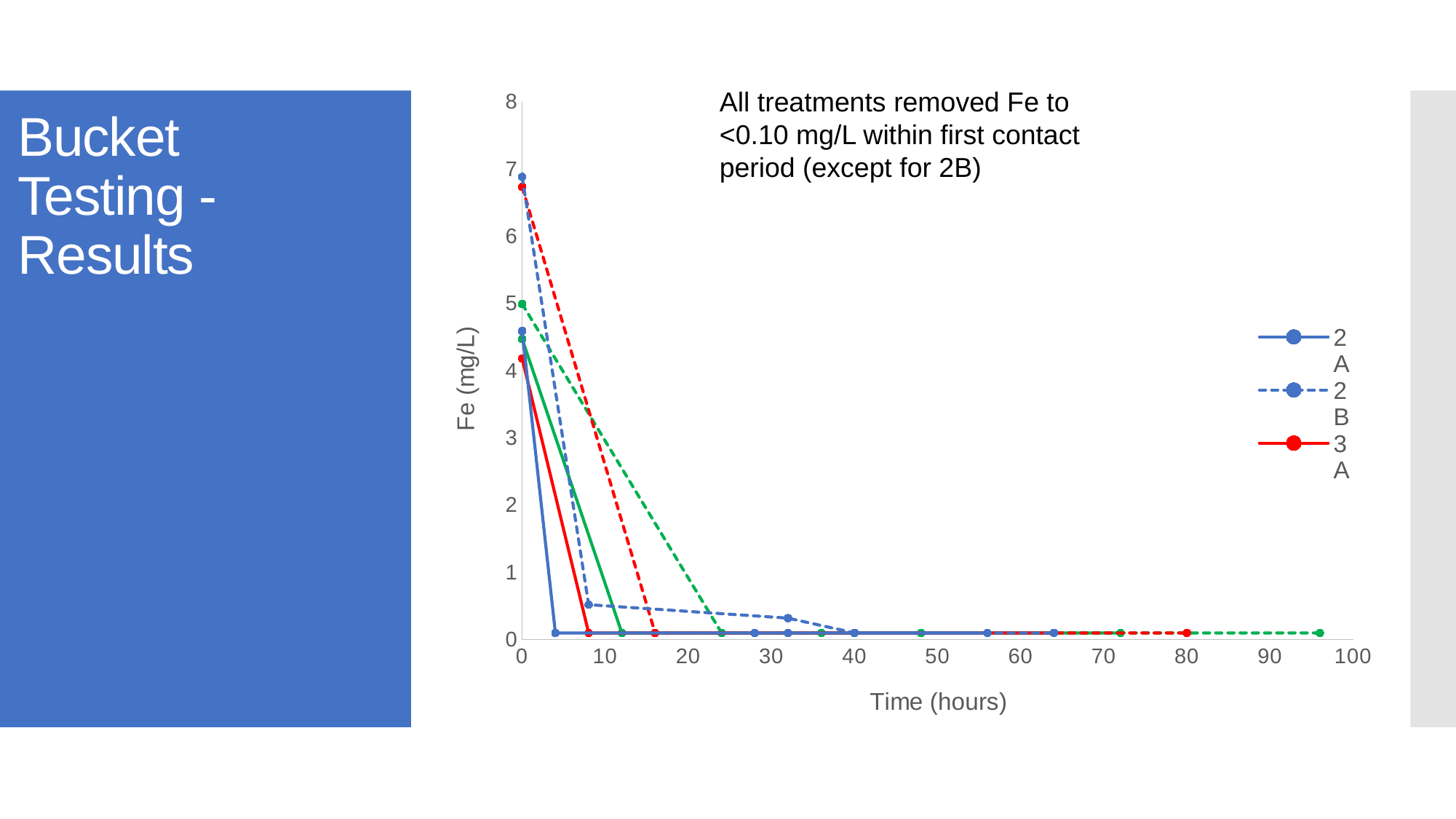
Do the Fe values rise or fall as time increases along the x axis? fall Which series has the higher value at time 0, 2A or 2B? 2B What is the highest tick value shown on the x axis? 100 Is the value for series 2A at time 0 greater or less than 4 mg/L? greater What kind of chart is shown on the slide? line chart What is the label of the y axis? Fe (mg/L) Is the value for series 2A at 4 hours greater or less than 1 mg/L? less Is the value for series 2B at 8 hours greater or less than 1 mg/L? less What is the label of the x axis? Time (hours) How many series does the legend list? 3